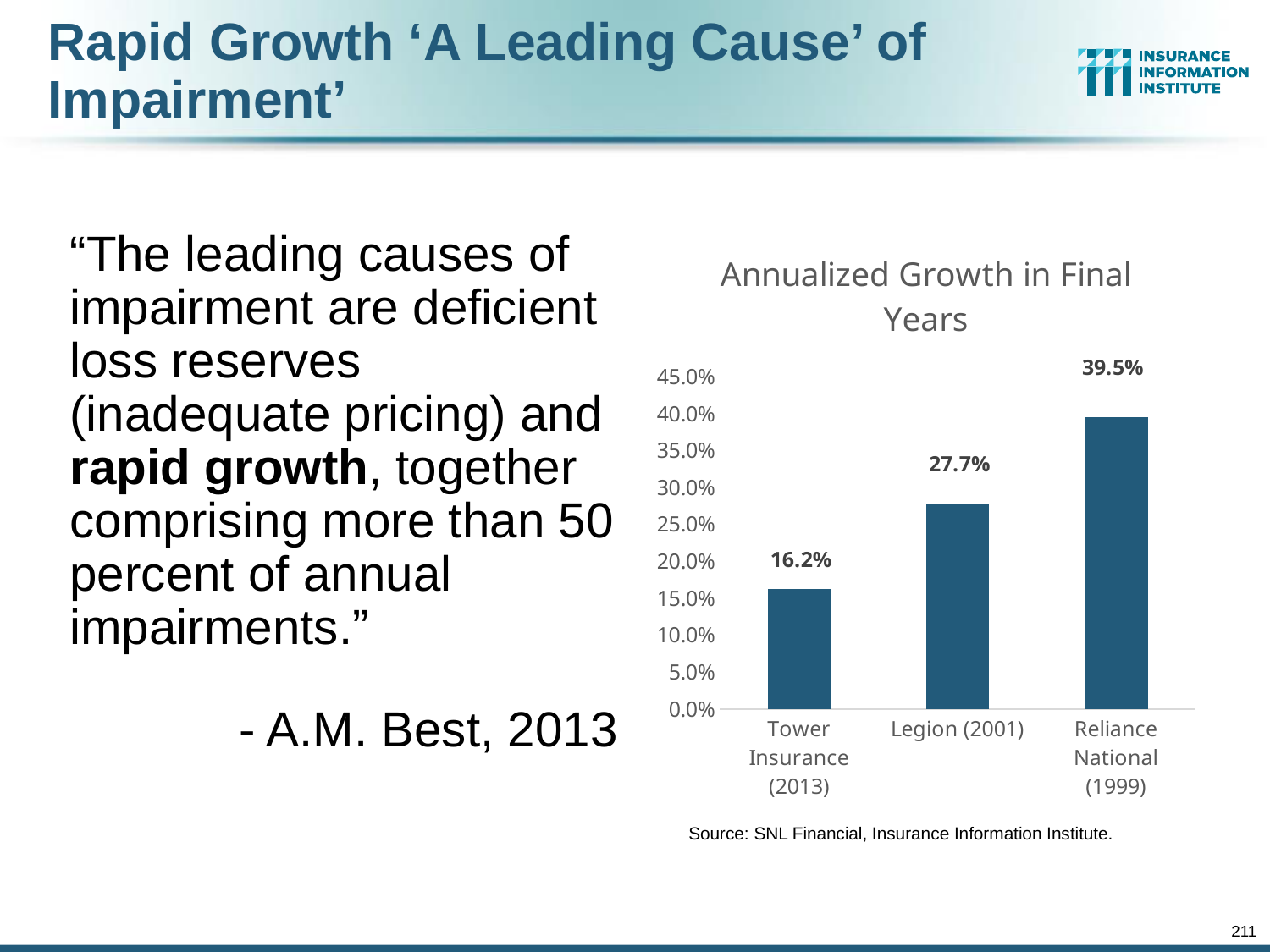
Is the annualized growth for Legion (2001) greater or less than 25.0%? greater Which company has the lowest annualized growth in final years? Tower Insurance (2013) What is the annualized growth in final years for Reliance National (1999)? 39.5% What kind of chart is shown on the slide? Bar chart What is the difference between the annualized growth of Legion (2001) and Tower Insurance (2013)? 11.5% What is the difference between the annualized growth of Reliance National (1999) and Tower Insurance (2013)? 23.3% What is the annualized growth in final years for Tower Insurance (2013)? 16.2% What is the annualized growth in final years for Legion (2001)? 27.7% How many companies are shown in the chart? 3 What is the title of the chart? Annualized Growth in Final Years Which company has the highest annualized growth in final years? Reliance National (1999) Which has a higher annualized growth in final years, Legion (2001) or Tower Insurance (2013)? Legion (2001)